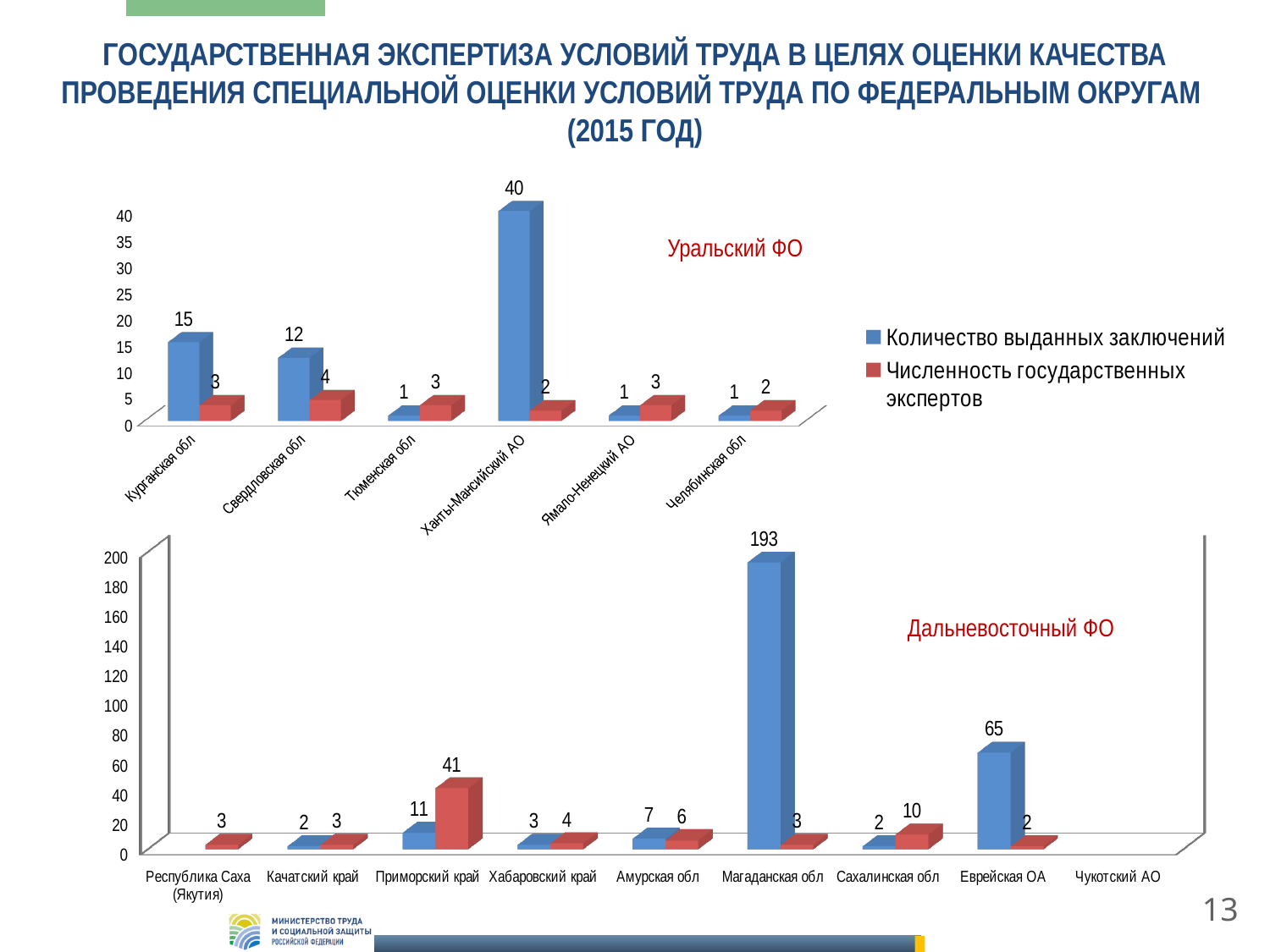
How many series does the legend list? 2 In the Уральский ФО chart, what is the value of Численность государственных экспертов for Свердловская обл? 4 In the Уральский ФО chart, what is the difference between Количество выданных заключений for Курганская обл and Свердловская обл? 3 In the Уральский ФО chart, how many regions are shown on the x axis? 6 In the Дальневосточный ФО chart, which region has the highest Численность государственных экспертов? Приморский край What type of chart is the Дальневосточный ФО chart? Bar chart In the Уральский ФО chart, what is the value of Количество выданных заключений for Ханты-Мансийский АО? 40 In the Дальневосточный ФО chart, what is the value of Численность государственных экспертов for Приморский край? 41 In the Дальневосточный ФО chart, which is larger for Амурская обл: Количество выданных заключений or Численность государственных экспертов? Количество выданных заключений In the Уральский ФО chart, which region has the highest Количество выданных заключений? Ханты-Мансийский АО In the Дальневосточный ФО chart, what is the difference between Количество выданных заключений for Магаданская обл and Еврейская ОА? 128 In the Дальневосточный ФО chart, what is the value of Количество выданных заключений for Магаданская обл? 193